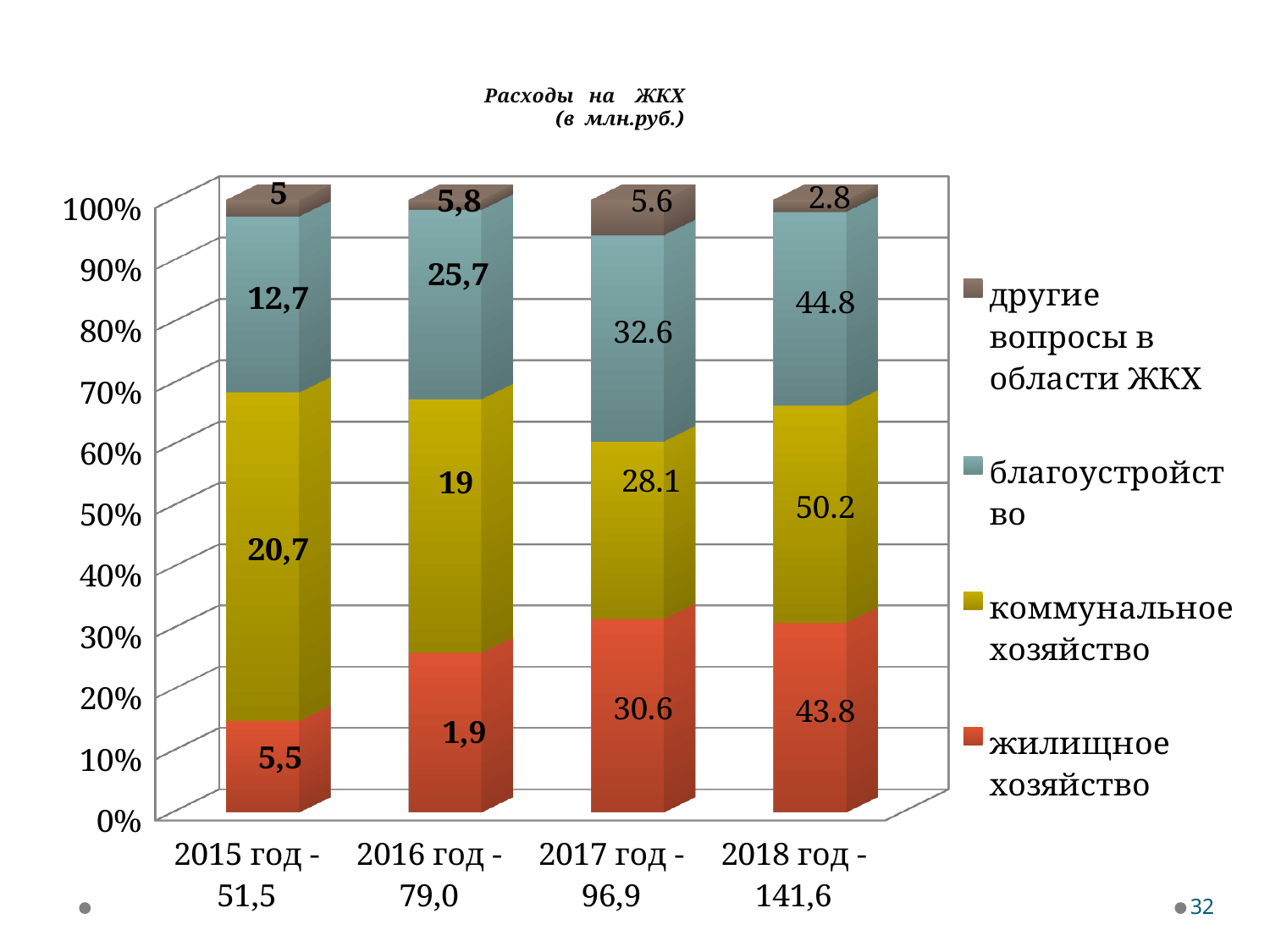
How many series does the legend list? 4 What is the value for коммунальное хозяйство in 2018? 50.2 What is the value for другие вопросы в области ЖКХ in 2017? 5.6 In which year is the value for жилищное хозяйство the highest? 2018 How many years (categories) are shown on the x axis? 4 What is the value for жилищное хозяйство in 2015? 5,5 What is the value for благоустройство in 2016? 25,7 Do the values for благоустройство rise or fall from 2015 to 2018? rise In 2017, which is larger: благоустройство or коммунальное хозяйство? благоустройство What kind of chart is this? stacked bar chart What is the difference between коммунальное хозяйство and жилищное хозяйство in 2018? 6.4